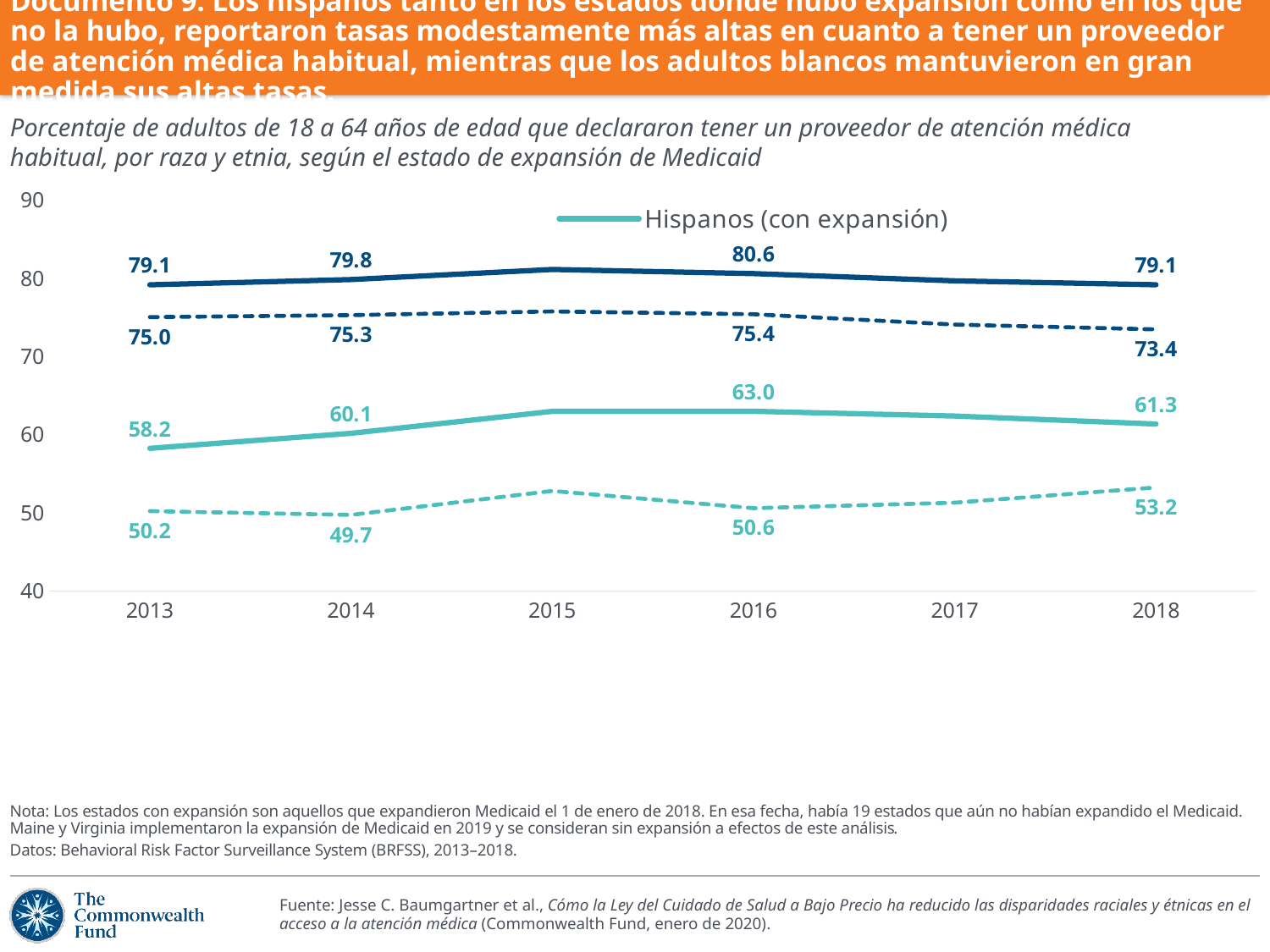
By how much did the value for Hispanos (con expansión) change from 2013 to 2016? 4.8 Does the value for Hispanos (con expansión) rise or fall from 2013 to 2016? rise What kind of chart is shown on the slide? line chart For Hispanos (con expansión), which year has the larger value, 2014 or 2018? 2018 What is the difference between the Hispanos (con expansión) values in 2018 and 2014? 1.2 What is the value for Hispanos (con expansión) in 2018? 61.3 What is the value for Hispanos (con expansión) in 2016? 63.0 What is the value for Hispanos (con expansión) in 2013? 58.2 How many years are shown on the x axis? 6 Is the value for Hispanos (con expansión) in 2015 greater or less than 60? greater What is the value for Hispanos (con expansión) in 2014? 60.1 In which year is the value for Hispanos (con expansión) lowest? 2013